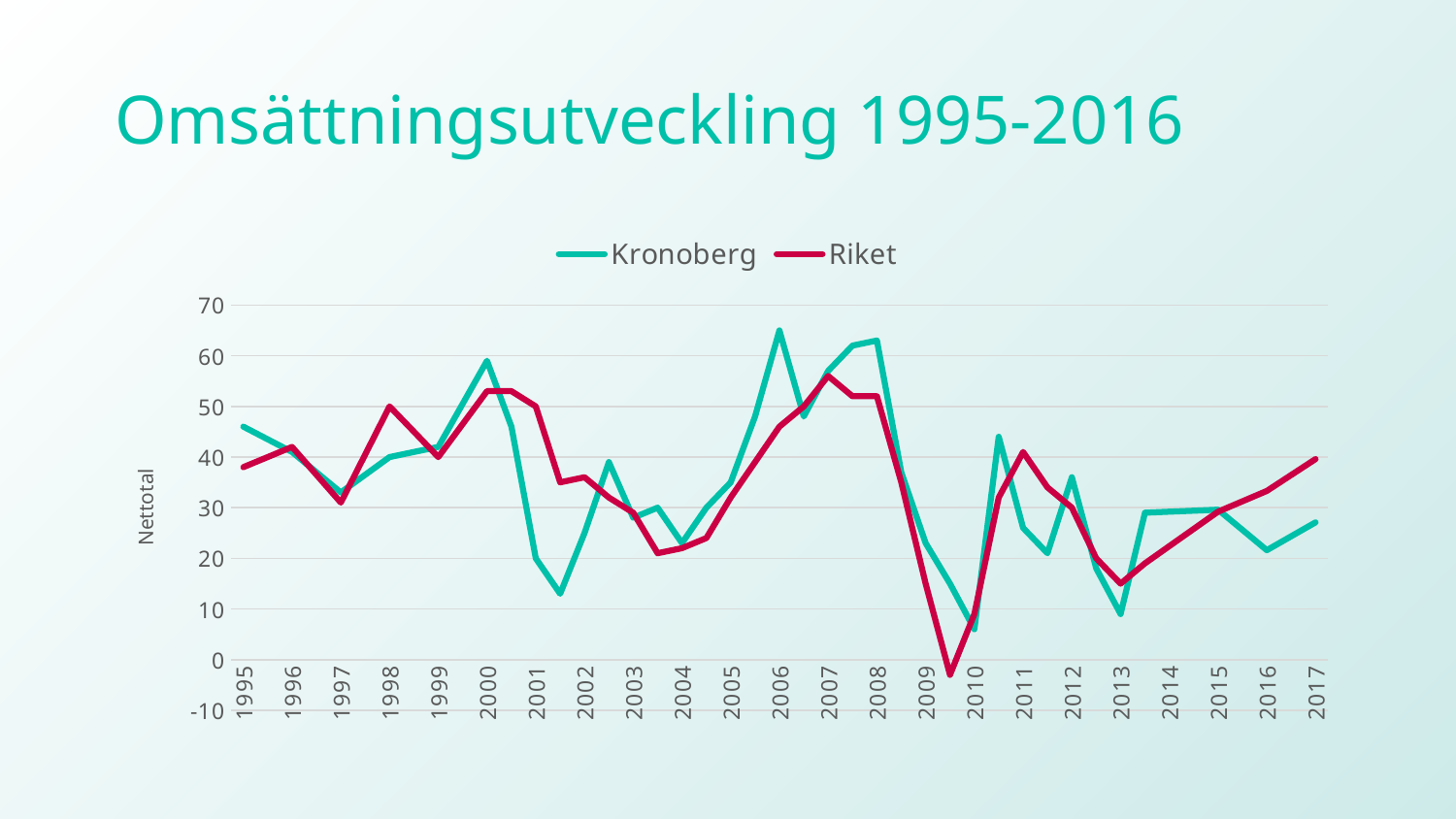
Is the value for Kronoberg at 2017 greater or less than 30? less What is the title of the chart? Omsättningsutveckling 1995-2016 At 2001, which series has the higher value, Kronoberg or Riket? Riket What is the label on the vertical axis? Nettotal At 2006, which series has the higher value, Kronoberg or Riket? Kronoberg What kind of chart is shown on the slide? line chart Is the lowest value of the Riket line greater or less than 0? less Is the value for Kronoberg at 2006 greater or less than 60? greater How many series does the legend list? 2 Around which year does the Kronoberg line reach its highest value? 2006 At 2011, which series has the higher value, Kronoberg or Riket? Riket